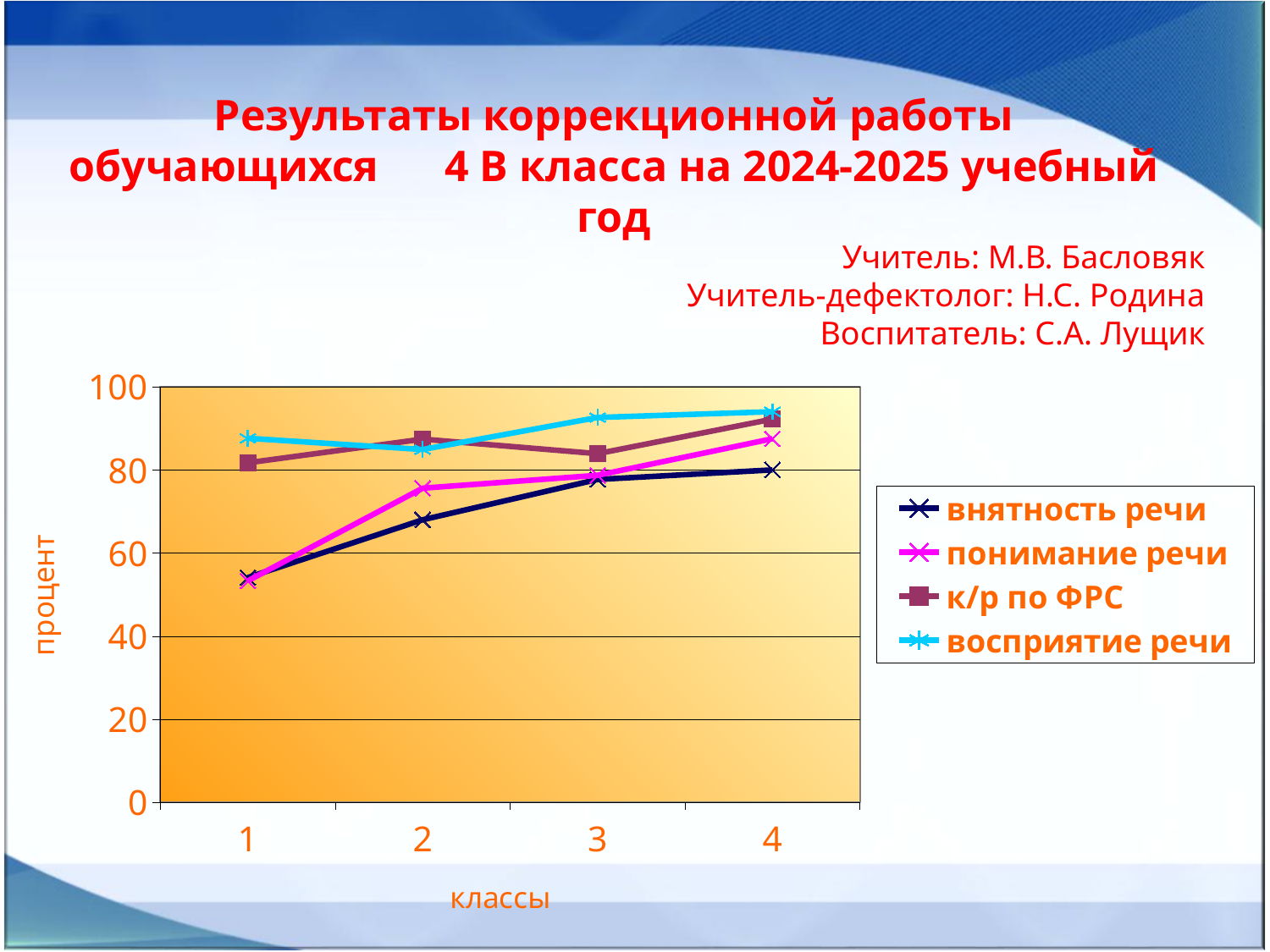
What is the title of the vertical axis? процент Does the value for внятность речи rise or fall from class 1 to class 4? rise Is the value for к/р по ФРС at class 2 greater or less than 80? greater How many classes (points) are plotted along the x axis? 4 At class 2, which is higher: к/р по ФРС or внятность речи? к/р по ФРС How many series does the legend list? 4 What kind of chart is shown on the slide? line chart Which series has the lowest value at class 4? внятность речи Does the value for понимание речи rise or fall from class 1 to class 4? rise Is the value for внятность речи at class 1 greater or less than 60? less At class 1, which is higher: восприятие речи or внятность речи? восприятие речи Is the value for восприятие речи at class 3 greater or less than 80? greater